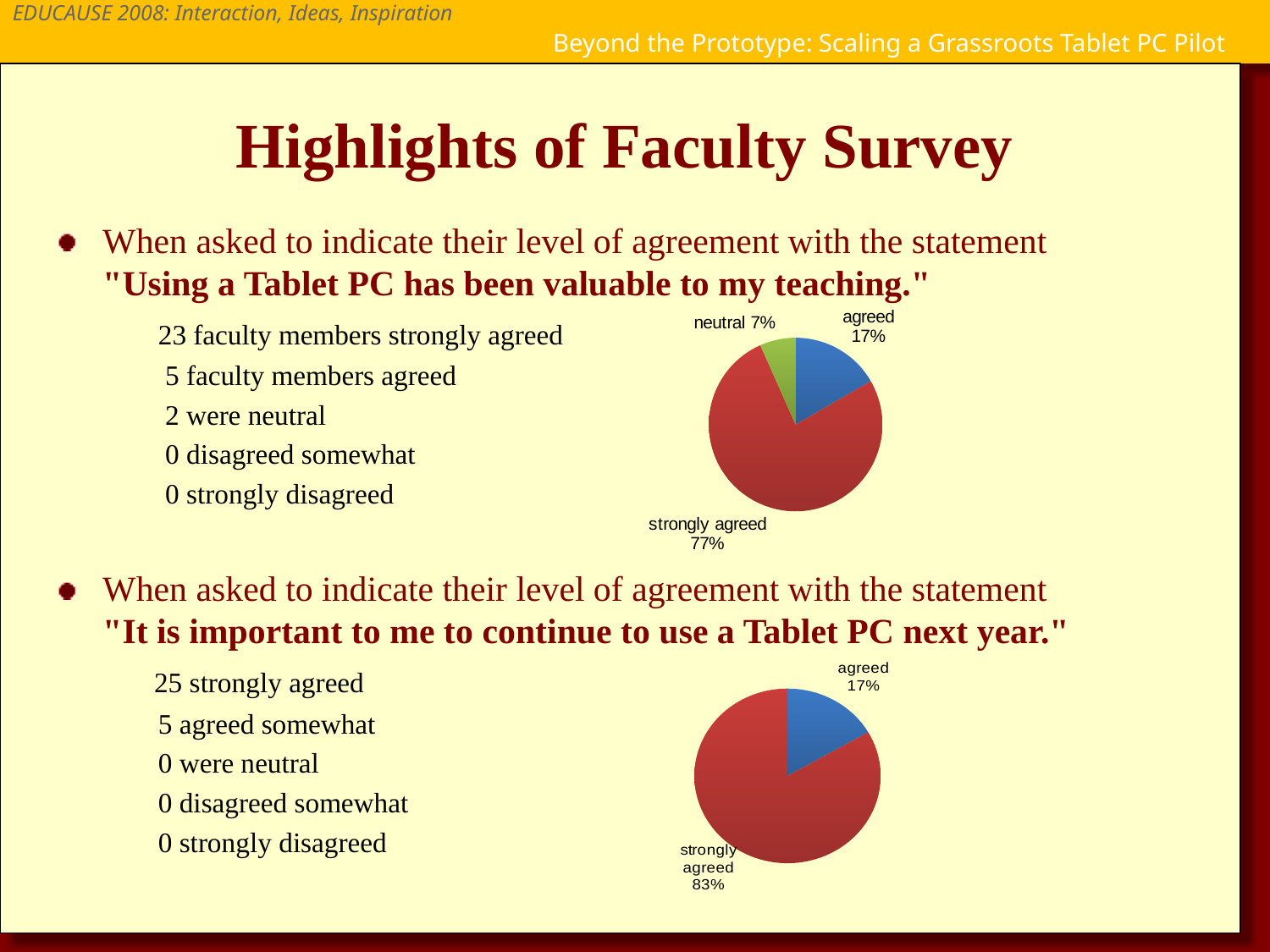
In the top pie chart, what is the difference in percentage points between "strongly agreed" and "agreed"? 60 In the bottom pie chart, which is larger, "strongly agreed" or "agreed"? strongly agreed In the top pie chart, which slice is the smallest? neutral In the top pie chart, what percentage is shown for "neutral"? 7% In the top pie chart, how many slices does the pie have? 3 In the top pie chart, what share of the pie is labelled "strongly agreed"? 77% In the bottom pie chart, what percentage is shown for "agreed"? 17% In the bottom pie chart, how many slices does the pie have? 2 In the bottom pie chart, what share of the pie is labelled "strongly agreed"? 83% What type of chart is the bottom chart on the slide? pie chart In the top pie chart, what percentage is shown for "agreed"? 17% In the top pie chart, which slice is the largest? strongly agreed